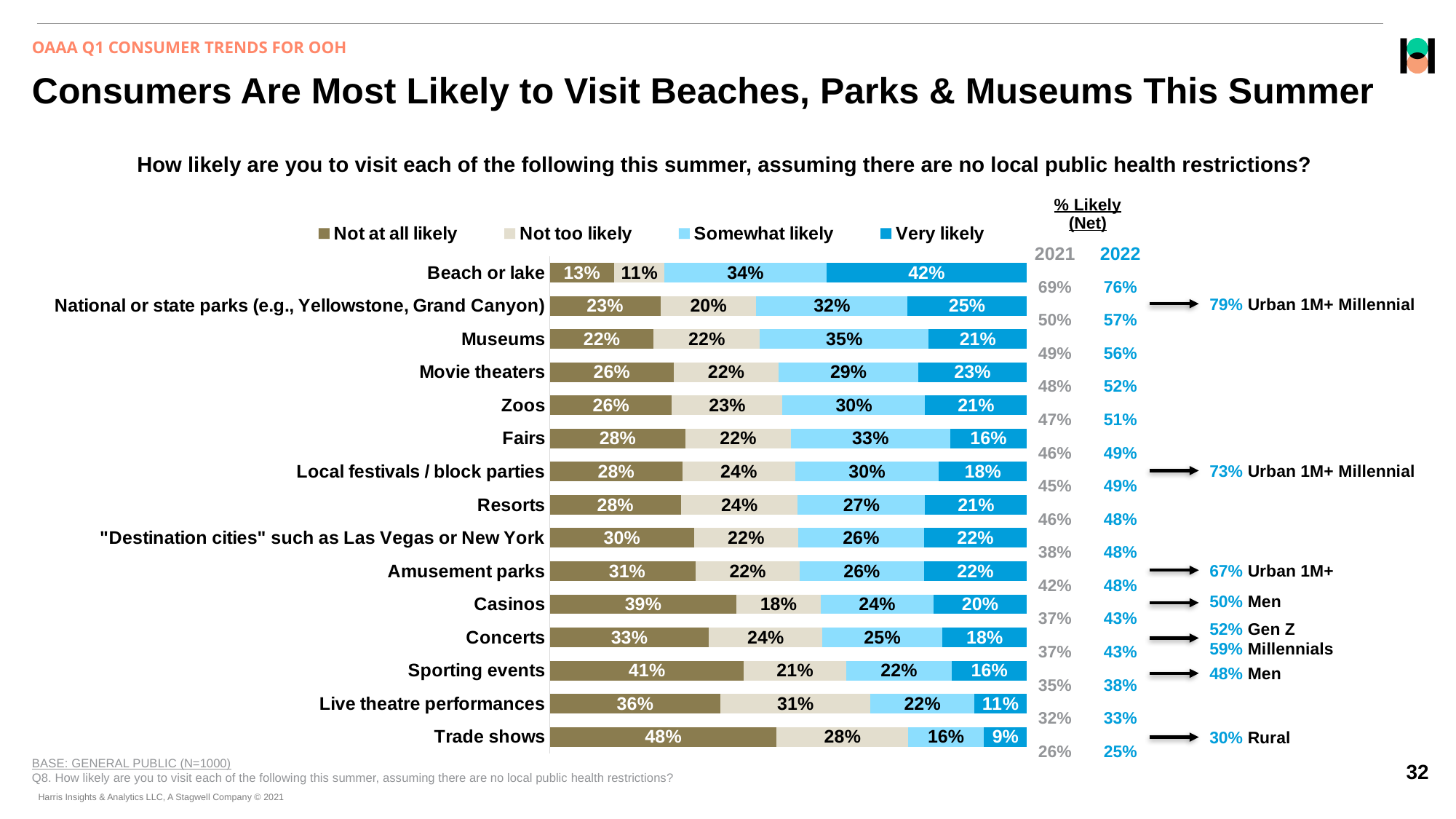
How many series does the legend list? 4 What percentage of respondents are "Not at all likely" to visit trade shows? 48% Which category has the lowest "Very likely" percentage? Trade shows Which category has the highest "Not at all likely" percentage? Trade shows How much higher is the "Somewhat likely" percentage for museums than for trade shows? 19 percentage points What is the "Not too likely" value for live theatre performances? 31% What are the four legend entries in the chart? Not at all likely, Not too likely, Somewhat likely, Very likely How many categories (activities) are shown in the chart? 15 Which category has the highest "Very likely" percentage? Beach or lake Which has a larger "Not at all likely" percentage: casinos or sporting events? Sporting events What percentage of respondents are "Very likely" to visit a beach or lake? 42% What kind of chart is shown on the slide? Stacked bar chart